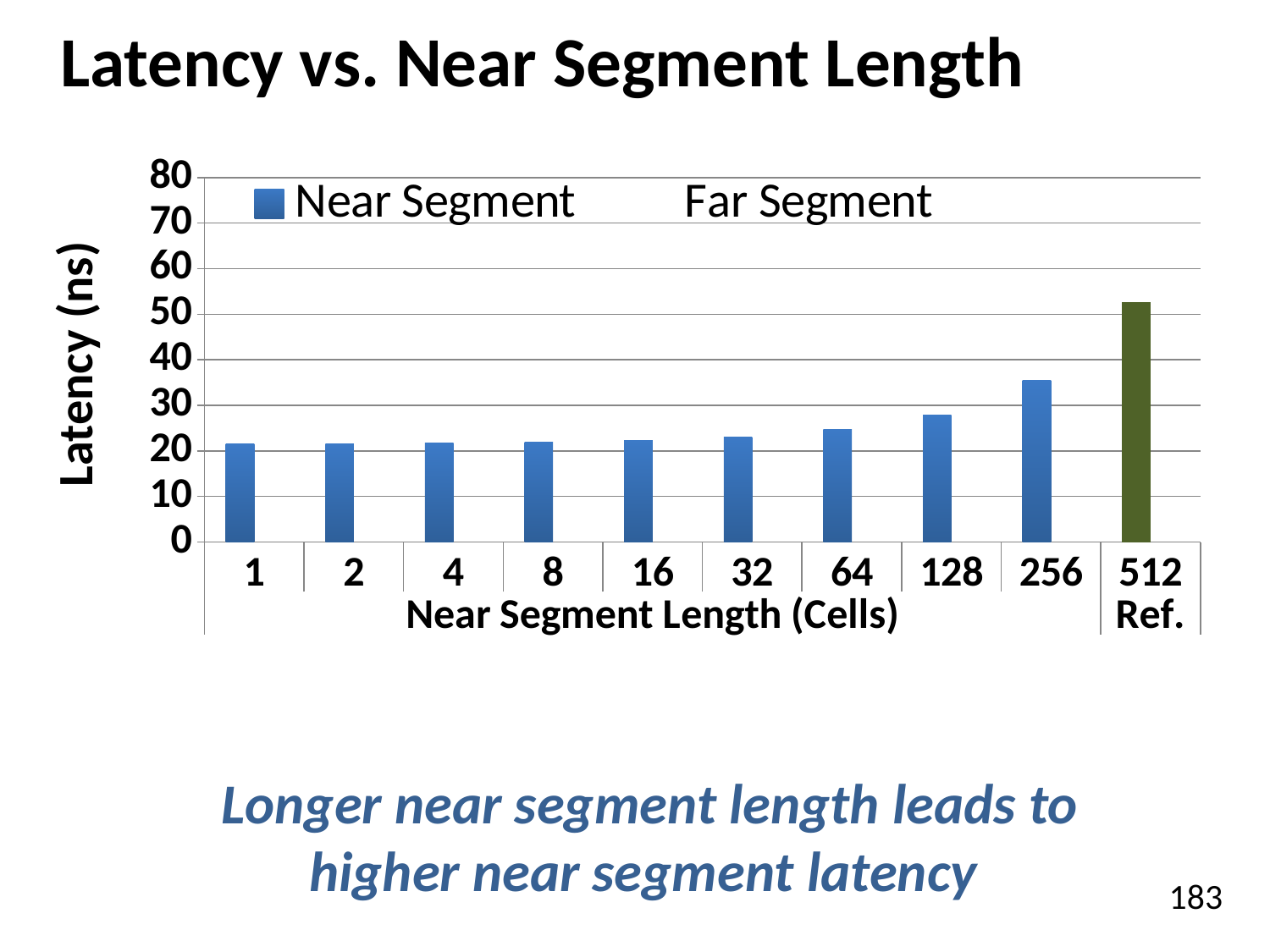
What kind of chart is shown on the slide? bar chart Which has the higher latency, 256 or 128? 256 Which category has the highest latency? 512 Ref. Is the latency for 512 Ref. greater or less than 50? greater Do the latency values rise or fall as near segment length increases from 1 to 256? rise Is the latency for 256 greater or less than 40? less How many series does the legend list? 2 Is the latency for 128 greater or less than 30? less How many bars are plotted in the chart? 10 What is the title of the chart? Latency vs. Near Segment Length What is the label of the y axis? Latency (ns)